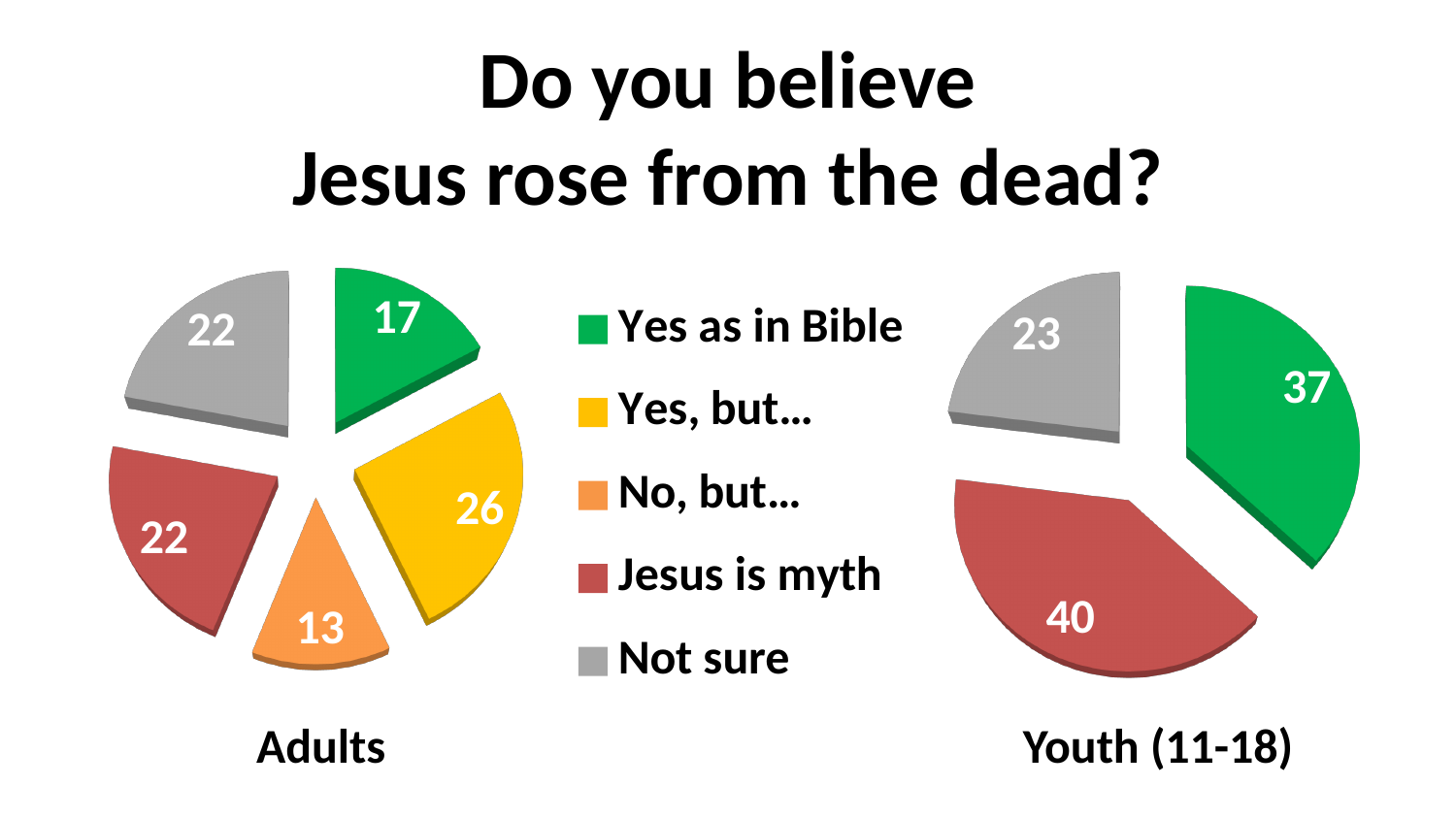
In the Adults pie chart, what is the value for "No, but…"? 13 In the Adults pie chart, which is larger: "Yes as in Bible" or "Jesus is myth"? Jesus is myth How many entries does the legend list? 5 In the Youth (11-18) pie chart, which category has the smallest slice? Not sure In the Youth (11-18) pie chart, what is the value for "Jesus is myth"? 40 What type of chart is used for the Adults data? Pie chart In the Adults pie chart, which category has the smallest slice? No, but… In the Youth (11-18) pie chart, what is the value for "Yes as in Bible"? 37 What is the difference between the "Yes as in Bible" value in the Youth (11-18) chart and the "Yes as in Bible" value in the Adults chart? 20 How many slices does the Youth (11-18) pie chart have? 3 In the Adults pie chart, what is the value for "Yes, but…"? 26 In the Adults pie chart, which category has the largest slice? Yes, but…